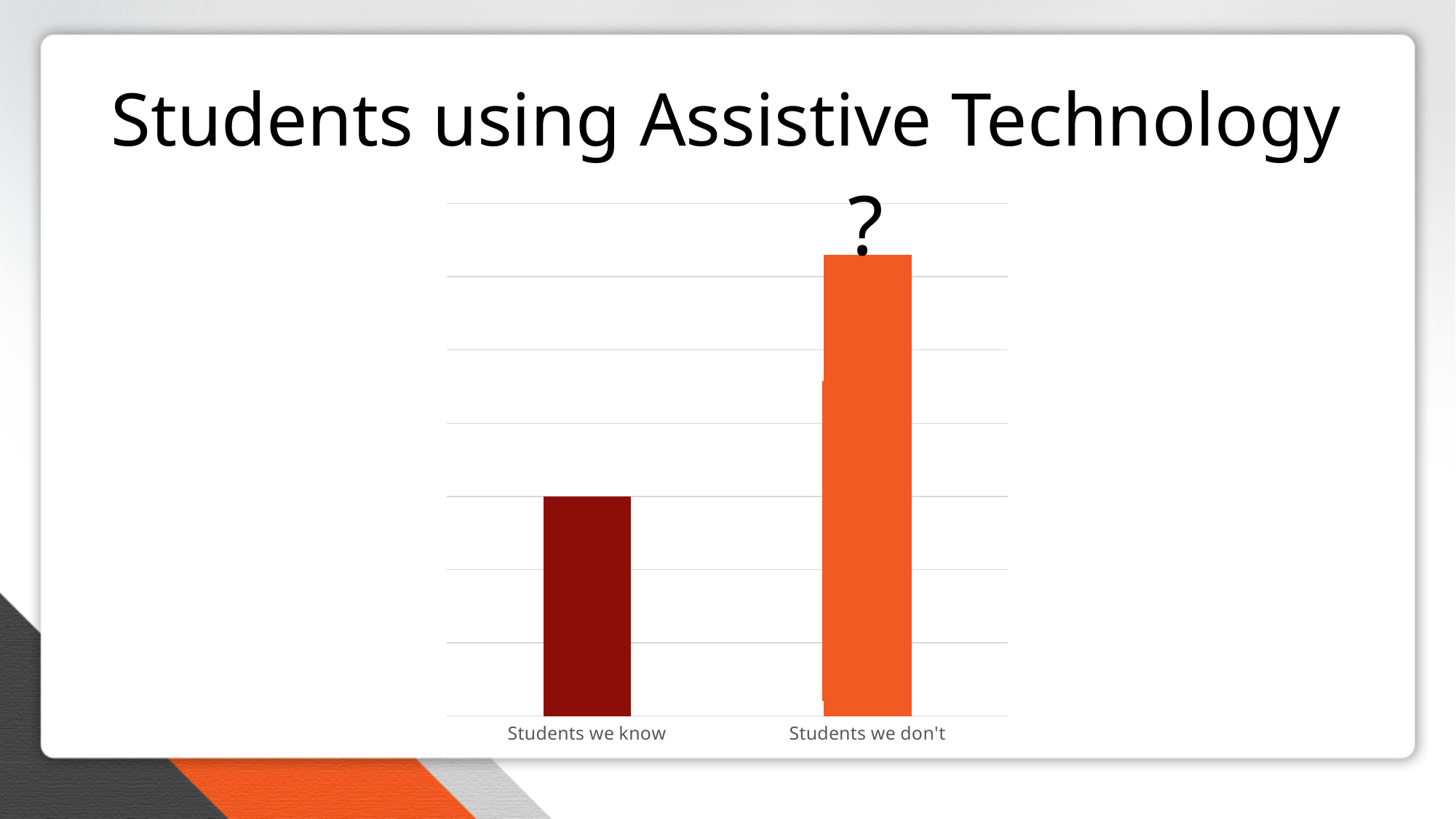
Which is larger, the bar for "Students we know" or the bar for "Students we don't"? Students we don't What is the title of the slide containing the chart? Students using Assistive Technology Which category has the lowest bar? Students we know What are the two category labels on the x axis of the chart? Students we know; Students we don't What kind of chart is shown on the slide? Bar chart What label is printed above the bar for "Students we don't"? ? Which category has the highest bar? Students we don't How many categories are plotted in the chart? 2